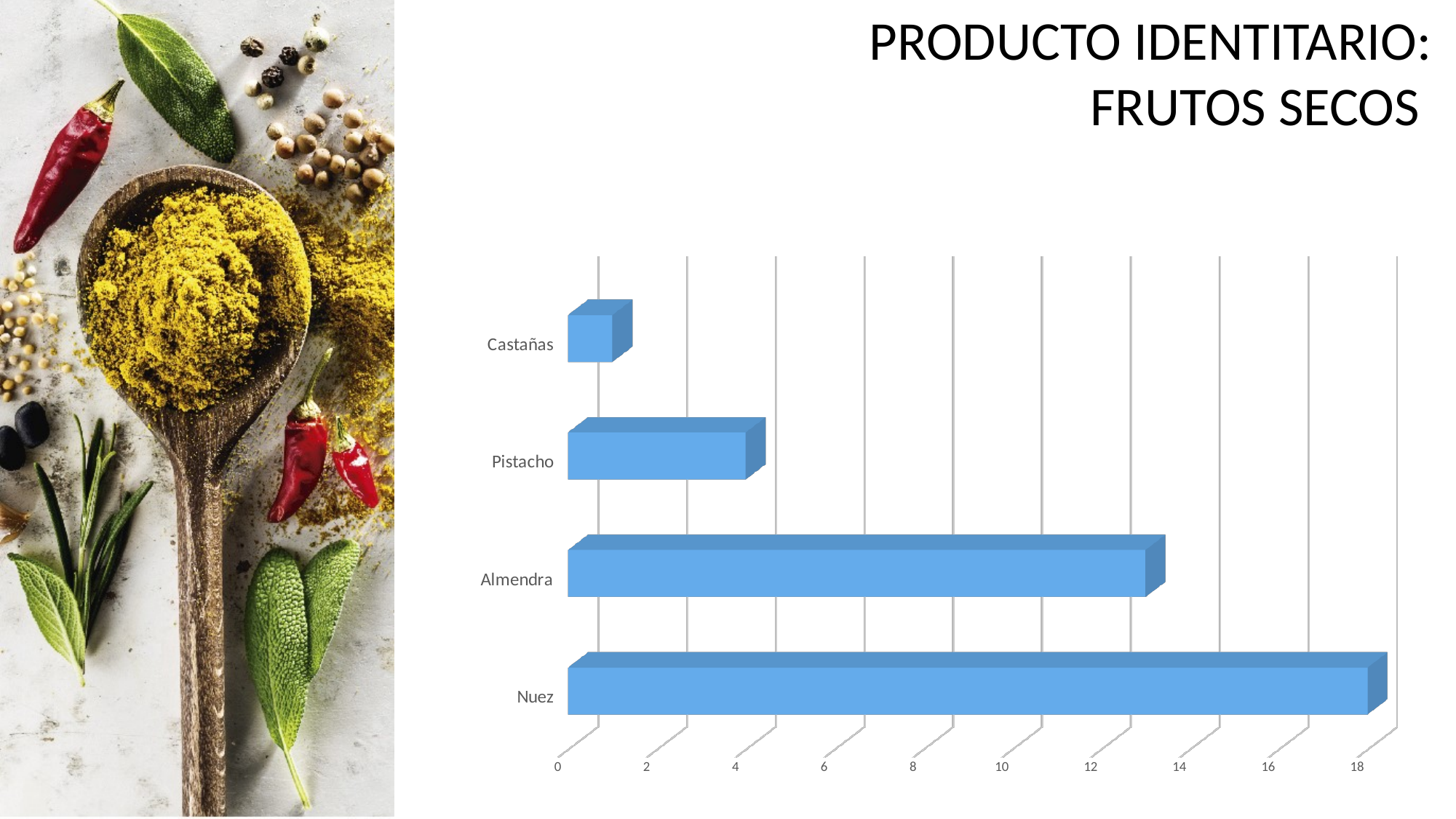
Is the value for Pistacho greater or less than 6? less Is the value for Almendra greater or less than 10? greater Is the value for Nuez greater or less than 16? greater Which has a larger value, Castañas or Pistacho? Pistacho Which category has the highest value in the chart? Nuez How many categories are shown in the chart? 4 Which has a larger value, Almendra or Pistacho? Almendra What kind of chart is shown on the slide? bar chart What is the highest value shown on the horizontal axis of the chart? 18 Which category has the lowest value in the chart? Castañas